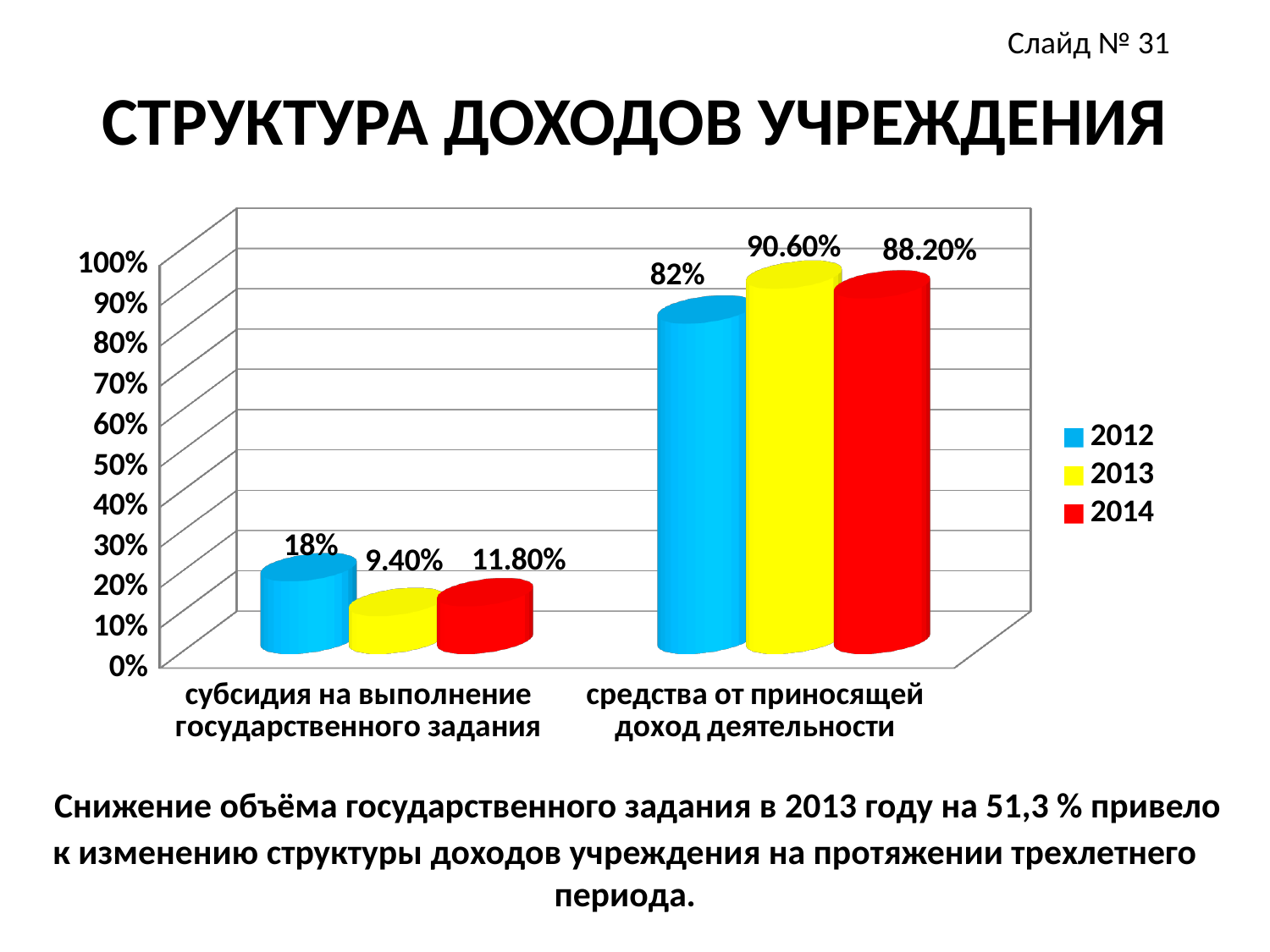
What is the value for 2013 in the category 'средства от приносящей доход деятельности'? 90.60% Which colour represents the 2013 series in the chart? Yellow What is the value for 2012 in the category 'субсидия на выполнение государственного задания'? 18% Which is larger: the 2012 value or the 2014 value in the category 'средства от приносящей доход деятельности'? 2014 Which year has the highest value in the category 'средства от приносящей доход деятельности'? 2013 What kind of chart is shown on the slide? Bar chart How many series does the legend list? 3 What is the value for 2014 in the category 'субсидия на выполнение государственного задания'? 11.80% Which year has the lowest value in the category 'субсидия на выполнение государственного задания'? 2013 What is the difference between the 2012 and 2013 values in the category 'субсидия на выполнение государственного задания'? 8.60% What is the value for 2014 in the category 'средства от приносящей доход деятельности'? 88.20% How many categories are shown on the x axis? 2